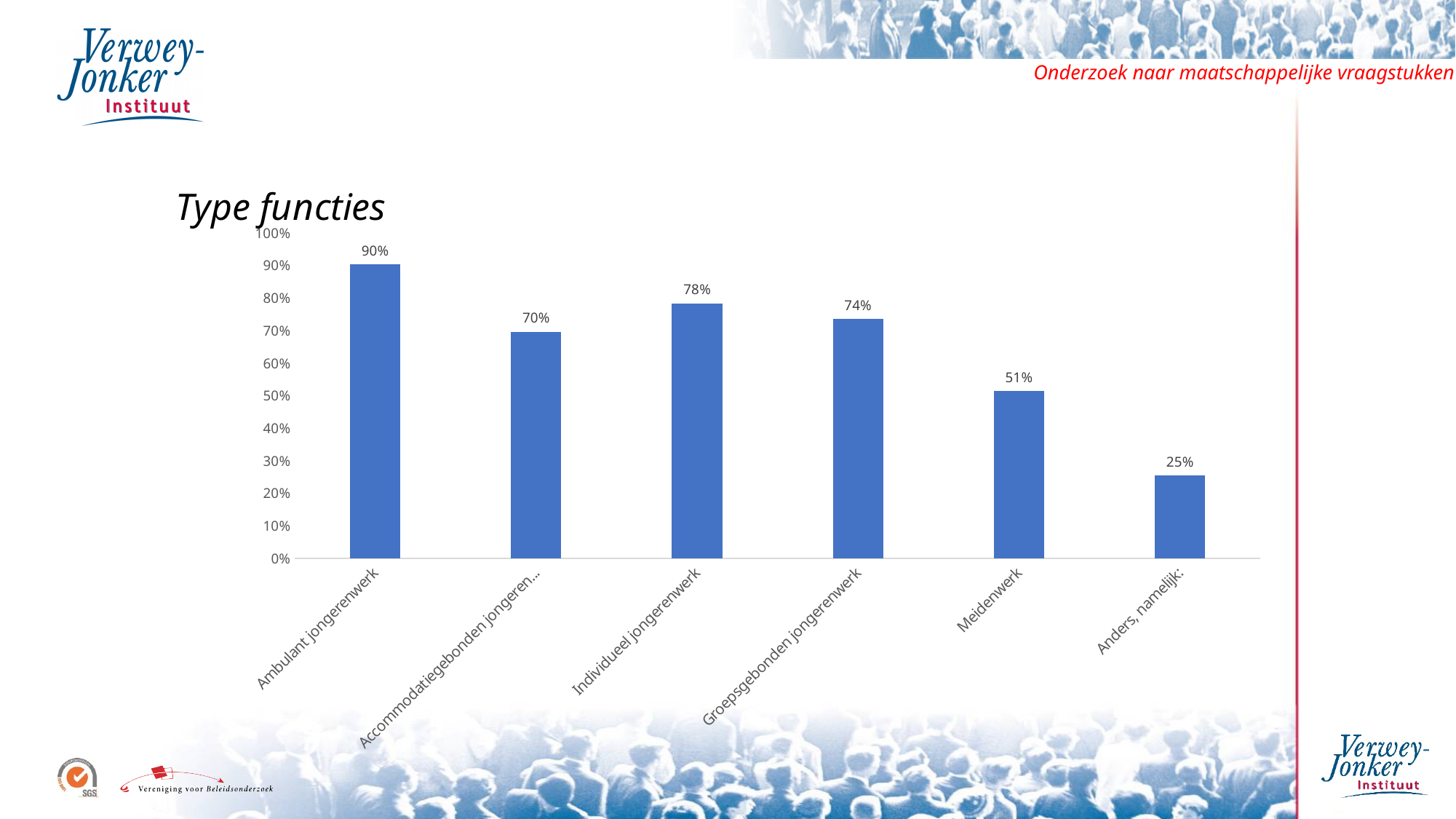
What is the value for Groepsgebonden jongerenwerk? 74% What is the title of the chart? Type functies Which category has the highest value? Ambulant jongerenwerk What is the difference between the values for Ambulant jongerenwerk and Meidenwerk? 39% How many categories are shown in the chart? 6 What is the value for Meidenwerk? 51% What is the value for Ambulant jongerenwerk? 90% What kind of chart is shown on the slide? bar chart Which is larger, the value for Individueel jongerenwerk or Groepsgebonden jongerenwerk? Individueel jongerenwerk Is the value for Anders, namelijk: greater or less than 30%? less Which category has the lowest value? Anders, namelijk: What is the value for Individueel jongerenwerk? 78%